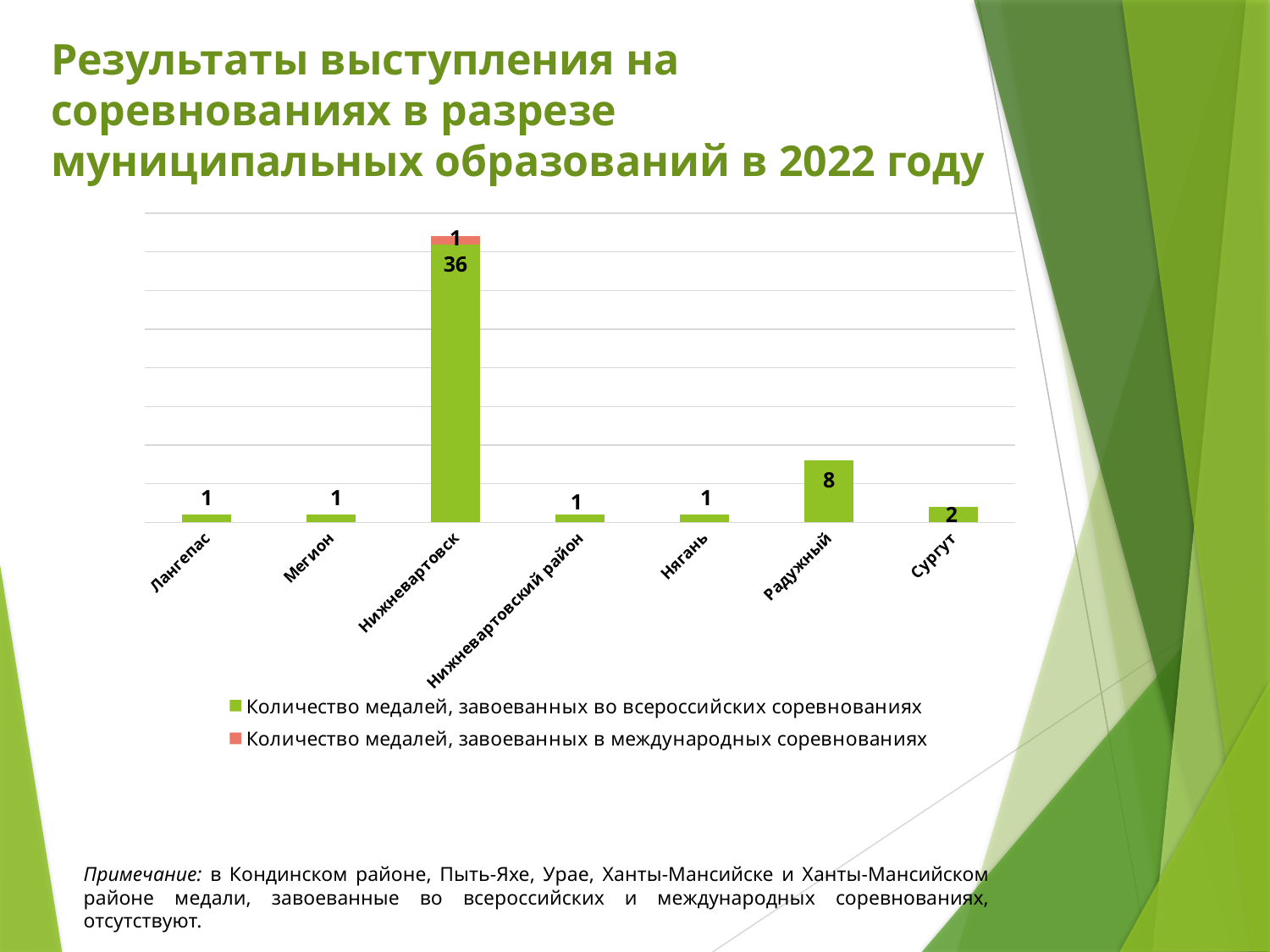
What kind of chart is shown on the slide? bar chart What is the difference between the all-Russian medals for Нижневартовск and the value for Радужный? 28 How many series does the chart legend list? 2 What is the total height of the stacked bar for Нижневартовск? 37 How many medals won in international competitions (Количество медалей, завоеванных в международных соревнованиях) are shown for Нижневартовск? 1 Which is larger, the value for Радужный or the value for Сургут? Радужный What is the value shown for Сургут? 2 What is the value shown for Нягань? 1 Which municipality has the highest number of medals in the chart? Нижневартовск How many medals won in all-Russian competitions (Количество медалей, завоеванных во всероссийских соревнованиях) are shown for Нижневартовск? 36 What is the value shown for Радужный? 8 How many municipalities (categories) are shown on the x axis of the chart? 7